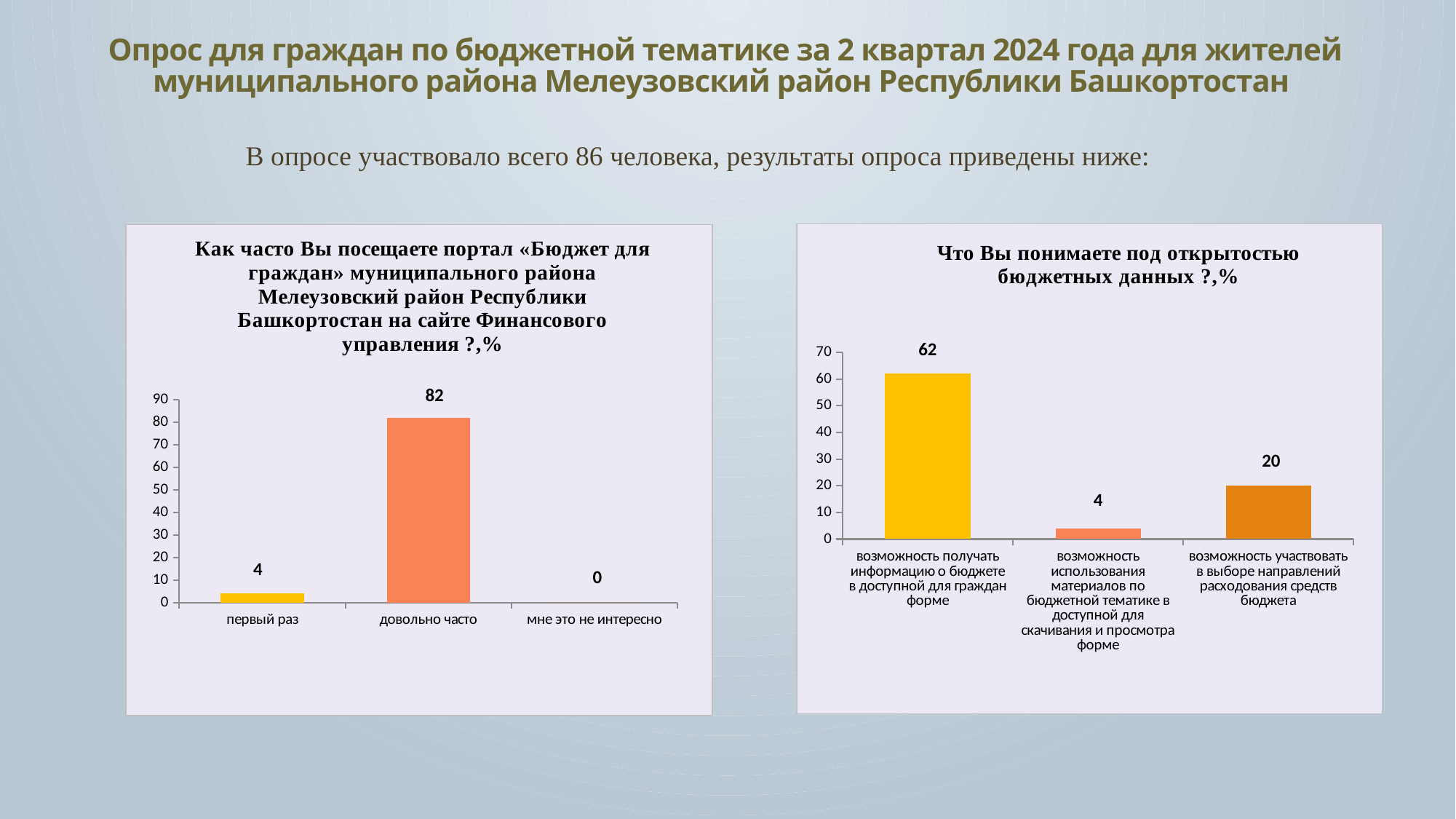
In the left chart ("Как часто Вы посещаете портал «Бюджет для граждан»..."), what is the value for "довольно часто"? 82 In the right chart ("Что Вы понимаете под открытостью бюджетных данных"), what is the value for "возможность участвовать в выборе направлений расходования средств бюджета"? 20 In the left chart, what is the value for "первый раз"? 4 In the left chart, what is the difference between the values for "довольно часто" and "первый раз"? 78 In the right chart, what is the highest value shown on the vertical axis? 70 In the left chart, how many categories are shown on the x axis? 3 In the right chart, which is larger: the value for "возможность участвовать в выборе направлений расходования средств бюджета" or the value for "возможность использования материалов по бюджетной тематике..."? возможность участвовать в выборе направлений расходования средств бюджета What type of chart is the left chart? bar chart In the left chart, which category has the lowest value? мне это не интересно In the right chart, what is the difference between the highest and lowest values? 58 In the right chart, which category has the highest value? возможность получать информацию о бюджете в доступной для граждан форме In the right chart, what is the value for "возможность использования материалов по бюджетной тематике в доступной для скачивания и просмотра форме"? 4